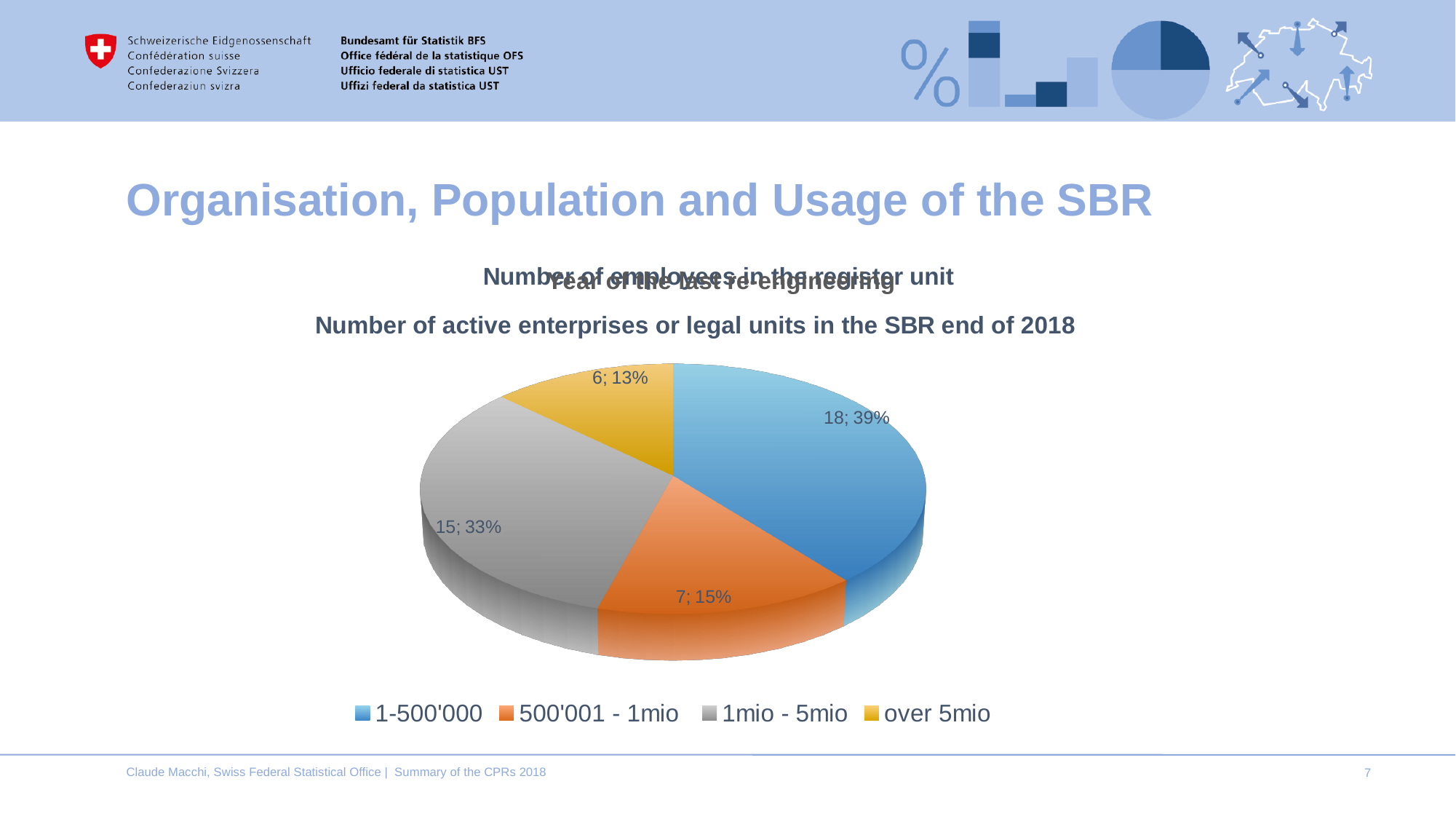
Which category has the smallest slice of the pie? over 5mio Which is larger, the '1mio - 5mio' slice or the 'over 5mio' slice? 1mio - 5mio What is the value shown for the '1-500'000' slice? 18; 39% What kind of chart is shown on the slide? pie chart How many slices does the pie chart have? 4 What is the value shown for the '500'001 - 1mio' slice? 7; 15% What share of the pie does the '1mio - 5mio' slice represent? 33% Which category has the largest slice of the pie? 1-500'000 How many entries does the legend of the pie chart list? 4 What is the difference in count between the '1-500'000' slice and the '500'001 - 1mio' slice? 11 What is the value shown for the 'over 5mio' slice? 6; 13% What is the value shown for the '1mio - 5mio' slice? 15; 33%